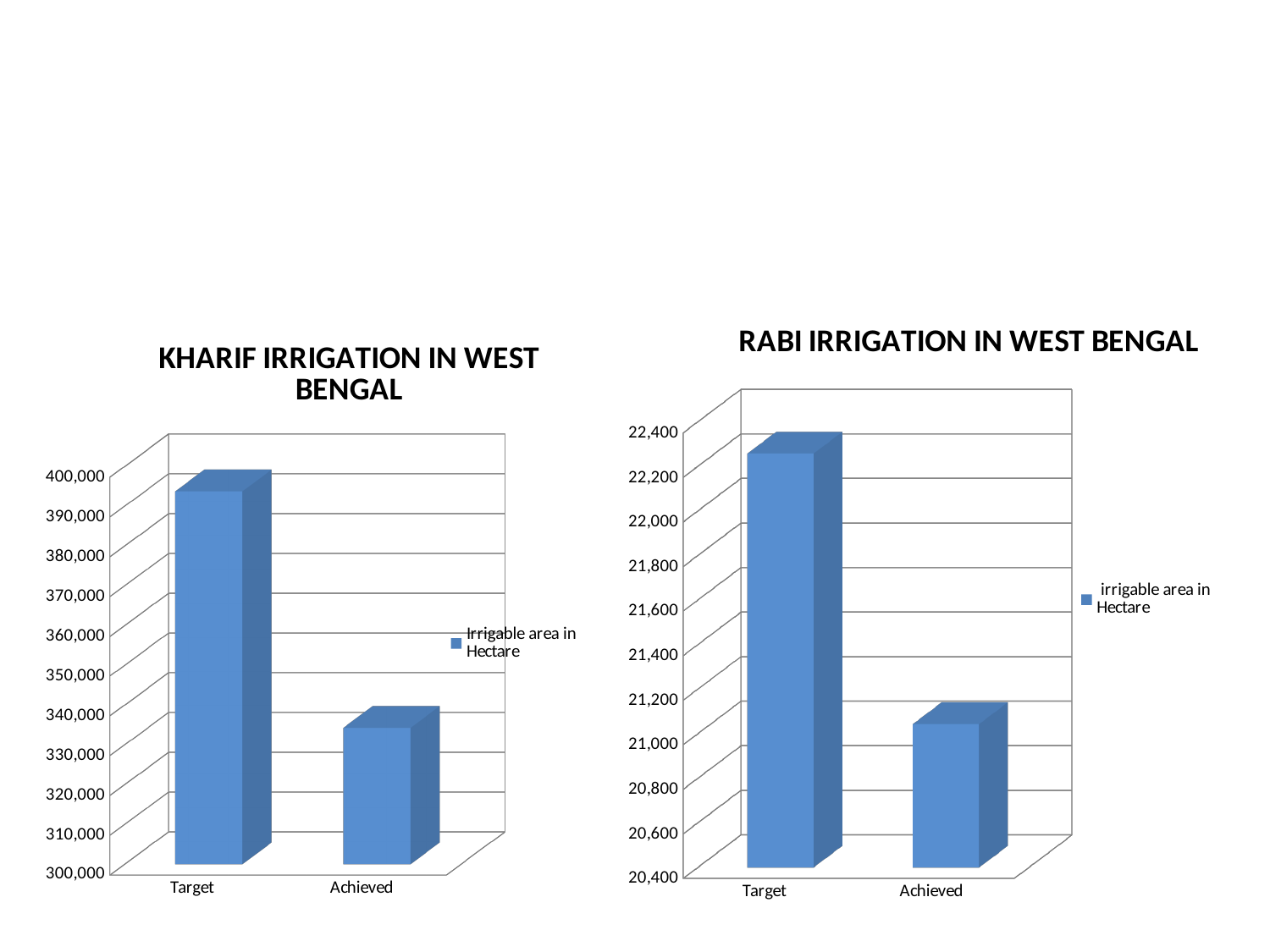
How many series does the legend of the RABI IRRIGATION IN WEST BENGAL chart list? 1 What kind of chart is the RABI IRRIGATION IN WEST BENGAL chart? bar chart In the KHARIF IRRIGATION IN WEST BENGAL chart, is the value for Target greater or less than 380,000? greater What is the legend entry in the KHARIF IRRIGATION IN WEST BENGAL chart? Irrigable area in Hectare In the RABI IRRIGATION IN WEST BENGAL chart, is the value for Target greater or less than 22,000? greater In the KHARIF IRRIGATION IN WEST BENGAL chart, which category has the highest value? Target What kind of chart is the KHARIF IRRIGATION IN WEST BENGAL chart? bar chart In the RABI IRRIGATION IN WEST BENGAL chart, which is larger, Target or Achieved? Target In the RABI IRRIGATION IN WEST BENGAL chart, which category has the lowest value? Achieved How many categories are shown on the x axis of the KHARIF IRRIGATION IN WEST BENGAL chart? 2 In the KHARIF IRRIGATION IN WEST BENGAL chart, is the value for Achieved greater or less than 350,000? less